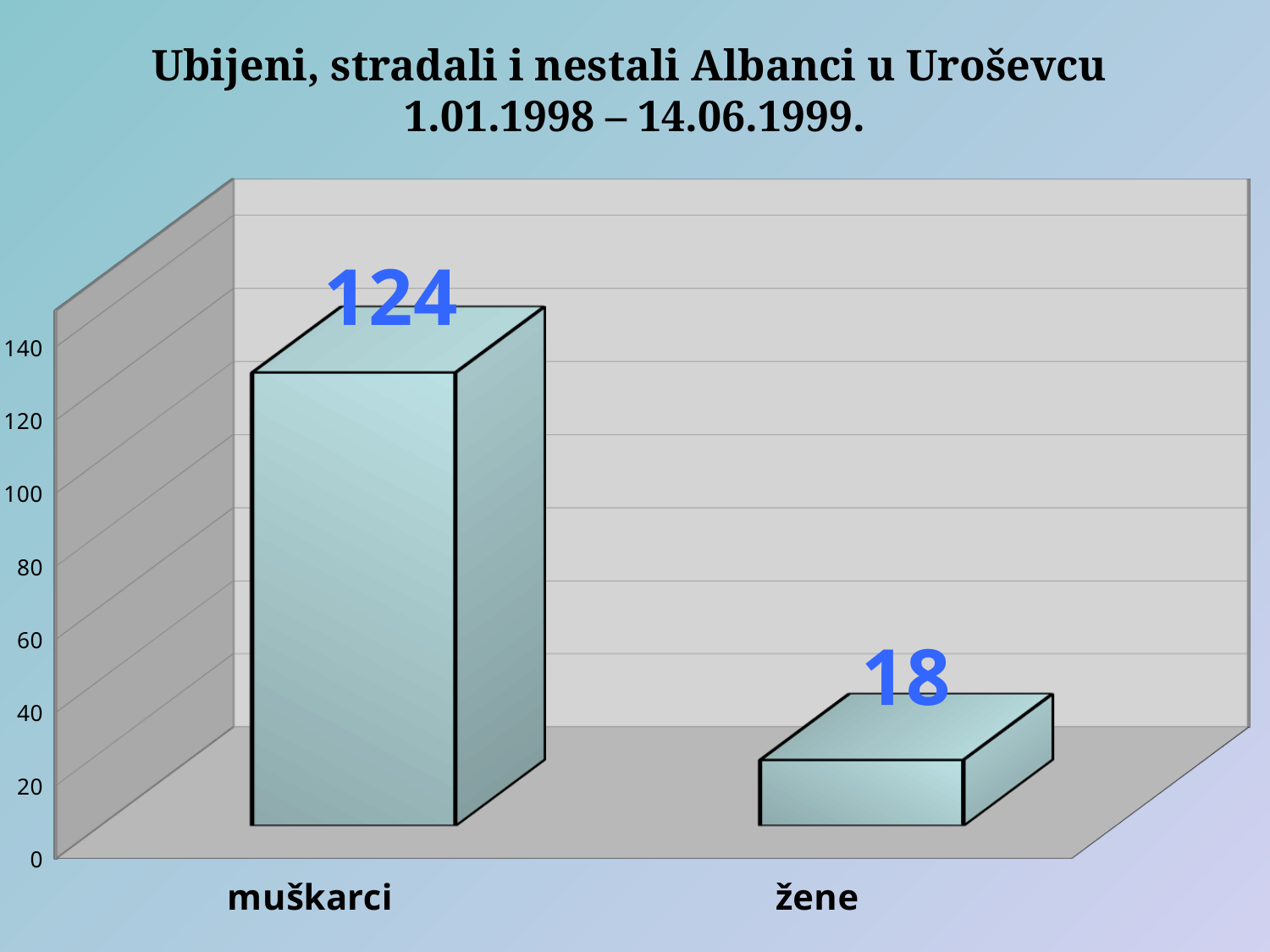
Is the value for muškarci greater or less than 100? greater What is the value for žene? 18 How many categories are shown on the chart? 2 Which category has the lowest value? žene Is the value for žene greater or less than 40? less What kind of chart is shown on the slide? bar chart What is the highest value shown on the vertical axis? 140 What is the title of the chart? Ubijeni, stradali i nestali Albanci u Uroševcu 1.01.1998 – 14.06.1999. What is the difference between the values for muškarci and žene? 106 What is the value for muškarci? 124 Which is larger, the value for muškarci or the value for žene? muškarci Which category has the highest value? muškarci